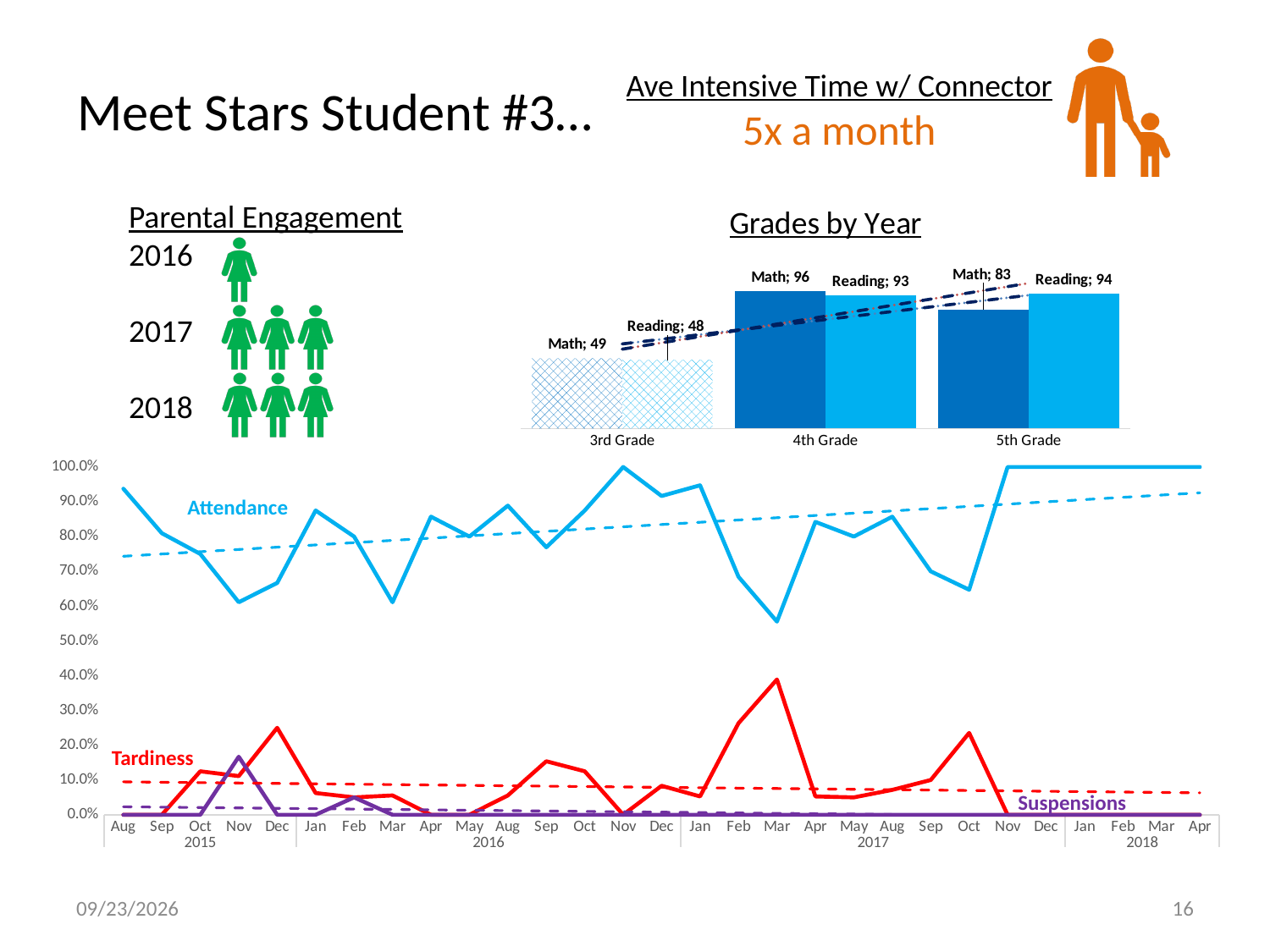
In the Grades by Year chart, what is the difference between the Math values for 4th Grade and 5th Grade? 13 How many grade categories are shown in the Grades by Year chart? 3 In the Grades by Year chart, which grade has the lowest Reading value? 3rd Grade In the Grades by Year chart, which grade has the highest Math value? 4th Grade What kind of chart is the Grades by Year chart? bar chart In the Grades by Year chart, is the Reading value larger for 3rd Grade or 4th Grade? 4th Grade In the Grades by Year chart, what is the Math value for 3rd Grade? 49 What kind of chart is the chart at the bottom of the slide showing Attendance, Tardiness and Suspensions? line chart In the Grades by Year chart, what is the Math value for 4th Grade? 96 In the line chart at the bottom of the slide, is the Attendance value for Mar 2017 greater or less than 60.0%? less In the line chart at the bottom of the slide, is the Tardiness value for Mar 2017 greater or less than 30.0%? greater In the Grades by Year chart, what is the Reading value for 5th Grade? 94